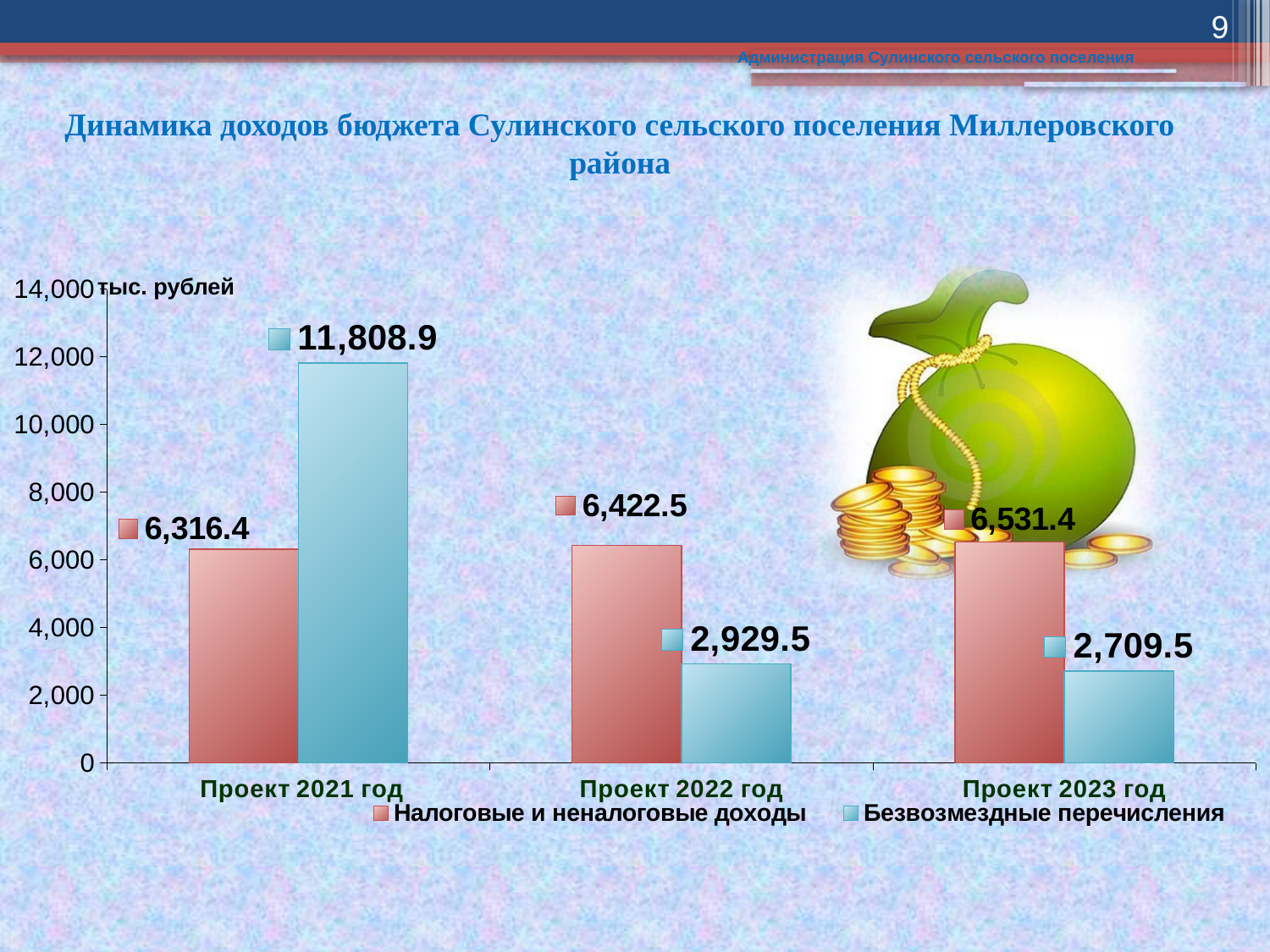
What is the value of Налоговые и неналоговые доходы for Проект 2021 год? 6,316.4 What is the difference between Безвозмездные перечисления and Налоговые и неналоговые доходы for Проект 2021 год? 5,492.5 How many series does the legend list? 2 What type of chart is shown on the slide? Bar chart What is the value of Безвозмездные перечисления for Проект 2022 год? 2,929.5 Do the values of Безвозмездные перечисления rise or fall from Проект 2021 год to Проект 2023 год? Fall In which year is the value of Налоговые и неналоговые доходы lowest? Проект 2021 год Which is larger for Проект 2022 год: Налоговые и неналоговые доходы or Безвозмездные перечисления? Налоговые и неналоговые доходы In which year is the value of Безвозмездные перечисления highest? Проект 2021 год How many year categories are shown on the x axis? 3 By how much does Безвозмездные перечисления for Проект 2022 год exceed that for Проект 2023 год? 220.0 What is the value of Безвозмездные перечисления for Проект 2023 год? 2,709.5